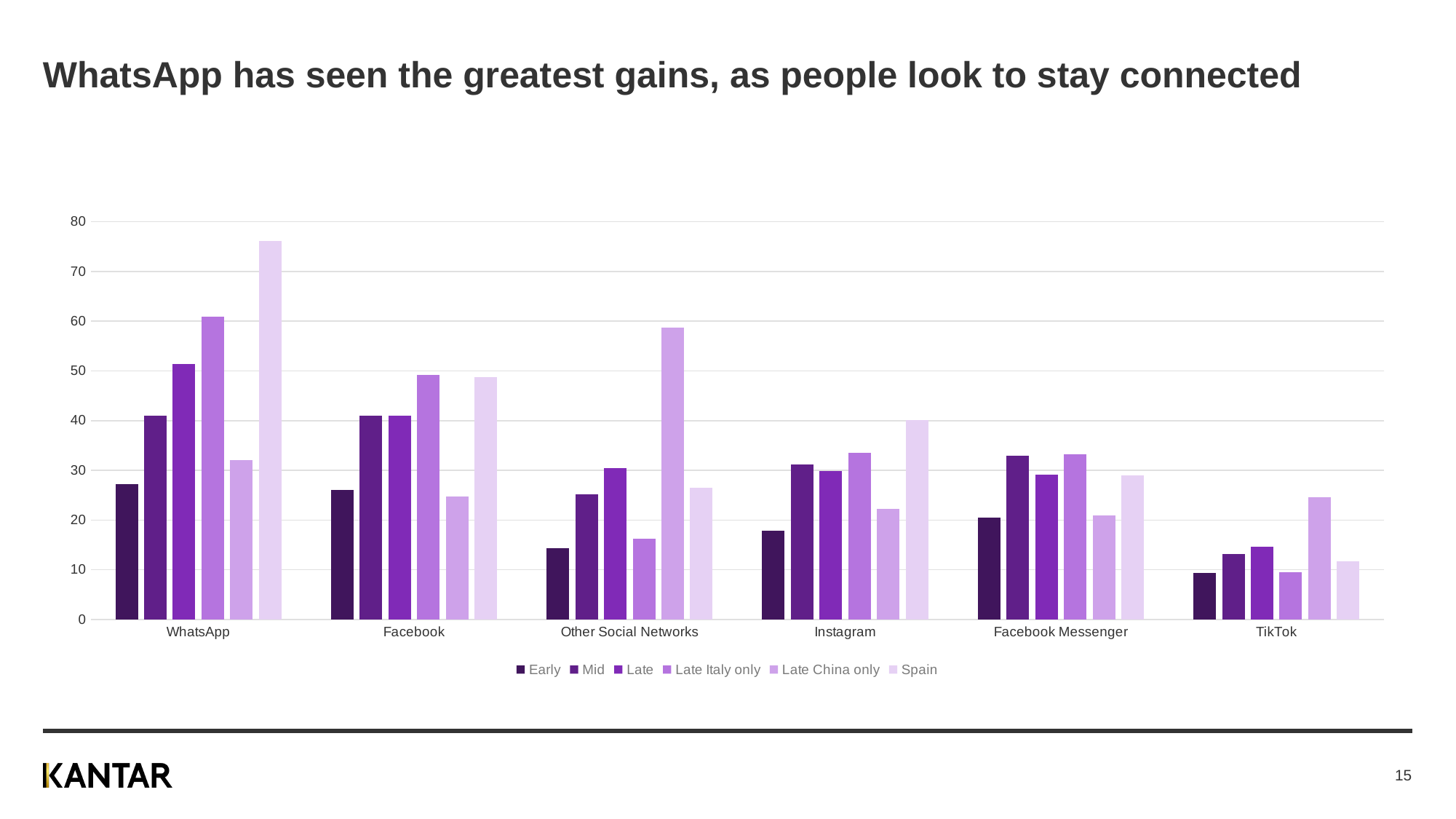
Which category has the highest value for the Spain series? WhatsApp How many categories are shown on the x axis of the chart? 6 Is the Late China only value for Other Social Networks greater or less than 50? greater What is the first series listed in the chart's legend? Early Which is larger: the Late Italy only value for WhatsApp or the Late Italy only value for Facebook? WhatsApp Which category has the lowest value for the Early series? TikTok How many series does the chart's legend list? 6 What kind of chart is shown on the slide? bar chart For Other Social Networks, which is larger: the Late China only value or the Spain value? Late China only Is the Spain value for WhatsApp greater or less than 70? greater Is the Early value for TikTok greater or less than 10? less Which category has the highest value for the Late China only series? Other Social Networks